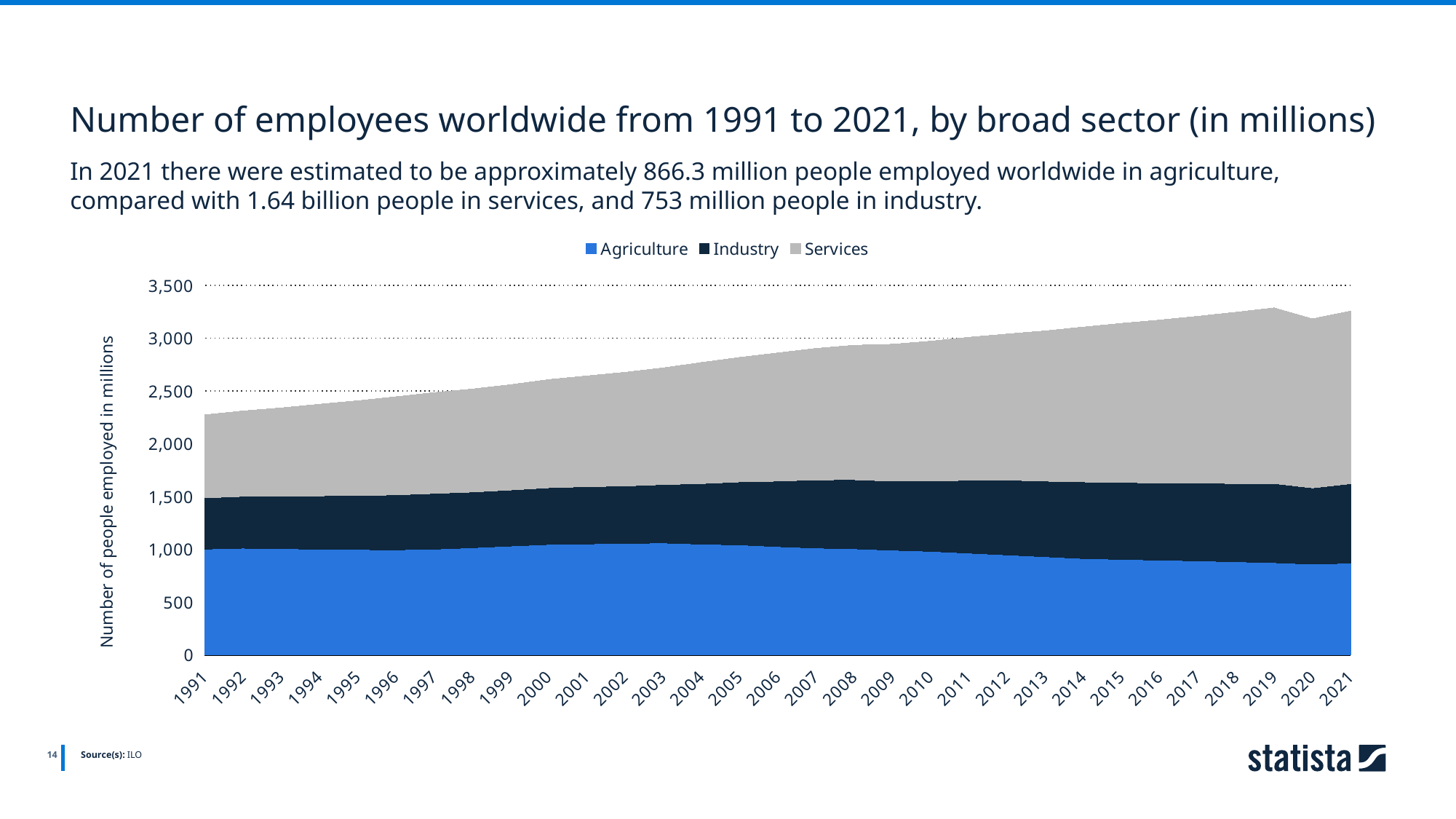
How many more people were employed in agriculture than in industry in 2021? 113.3 million According to the slide, how many people were employed worldwide in industry in 2021? 753 million What kind of chart is shown on the slide? Stacked area chart How many years are shown along the x axis? 31 Does the number of people employed in services rise or fall from 1991 to 2021? Rise According to the slide, how many people were employed worldwide in services in 2021? 1.64 billion According to the slide, how many people were employed worldwide in agriculture in 2021? 866.3 million In 2021, which sector employed more people: agriculture or industry? Agriculture Is the total number of employees across all sectors in 2021 greater or less than 3,000 million? greater Which sector had the largest number of employees in 2021? Services Which sector had the smallest number of employees in 2021? Industry How many series does the legend list? 3